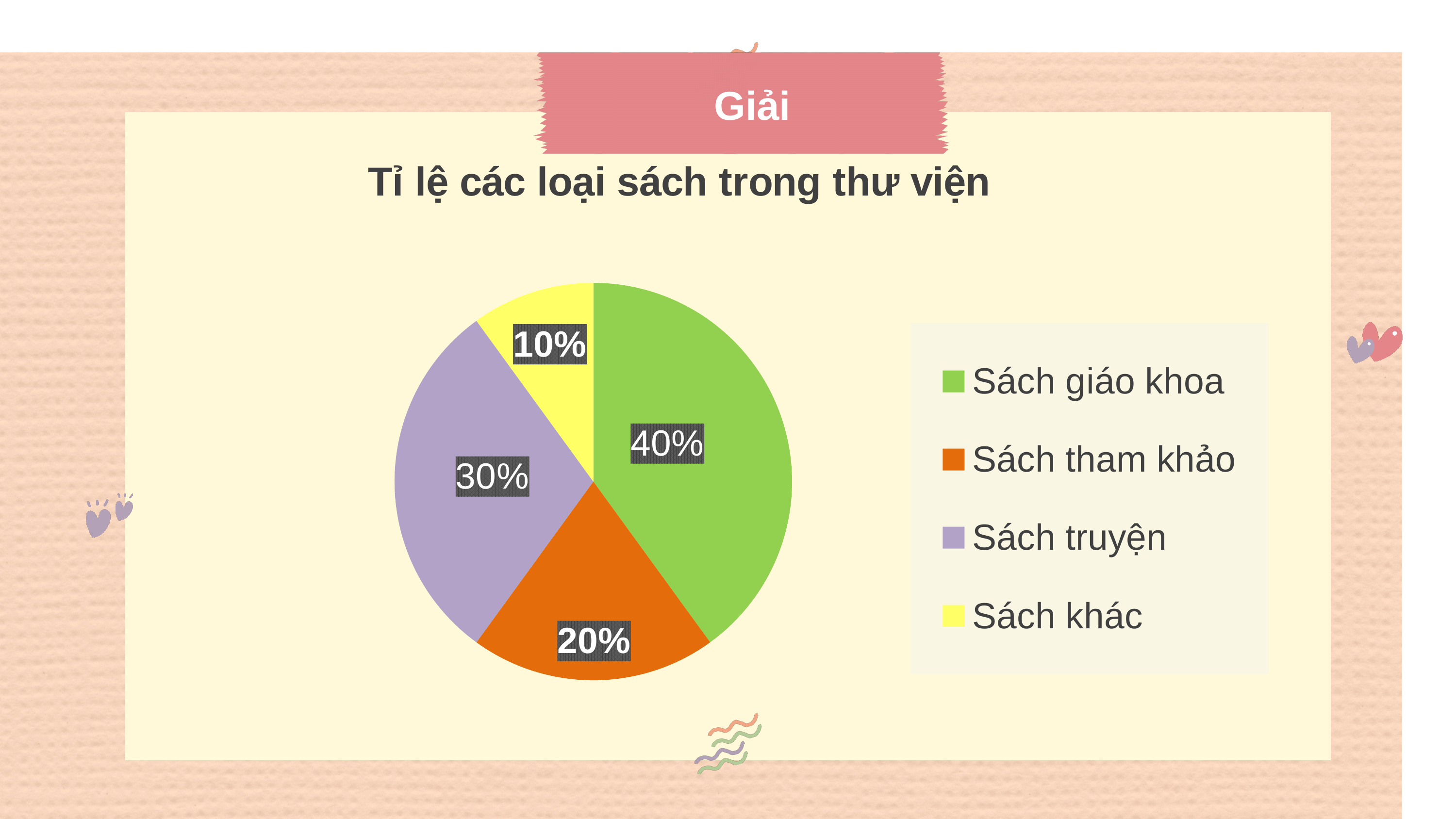
What is the title of the chart? Tỉ lệ các loại sách trong thư viện Which category has the smallest share of the pie? Sách khác What percentage of the pie is Sách tham khảo? 20% What percentage of the pie is Sách truyện? 30% What percentage of the pie is Sách khác? 10% Which category has the largest share of the pie? Sách giáo khoa How many categories does the pie chart have? 4 What is the difference between the shares of Sách giáo khoa and Sách truyện? 10% What percentage of the pie is Sách giáo khoa? 40% What colour is the slice for Sách truyện? purple What type of chart is shown on the slide? pie chart Which is larger, the share of Sách tham khảo or the share of Sách truyện? Sách truyện